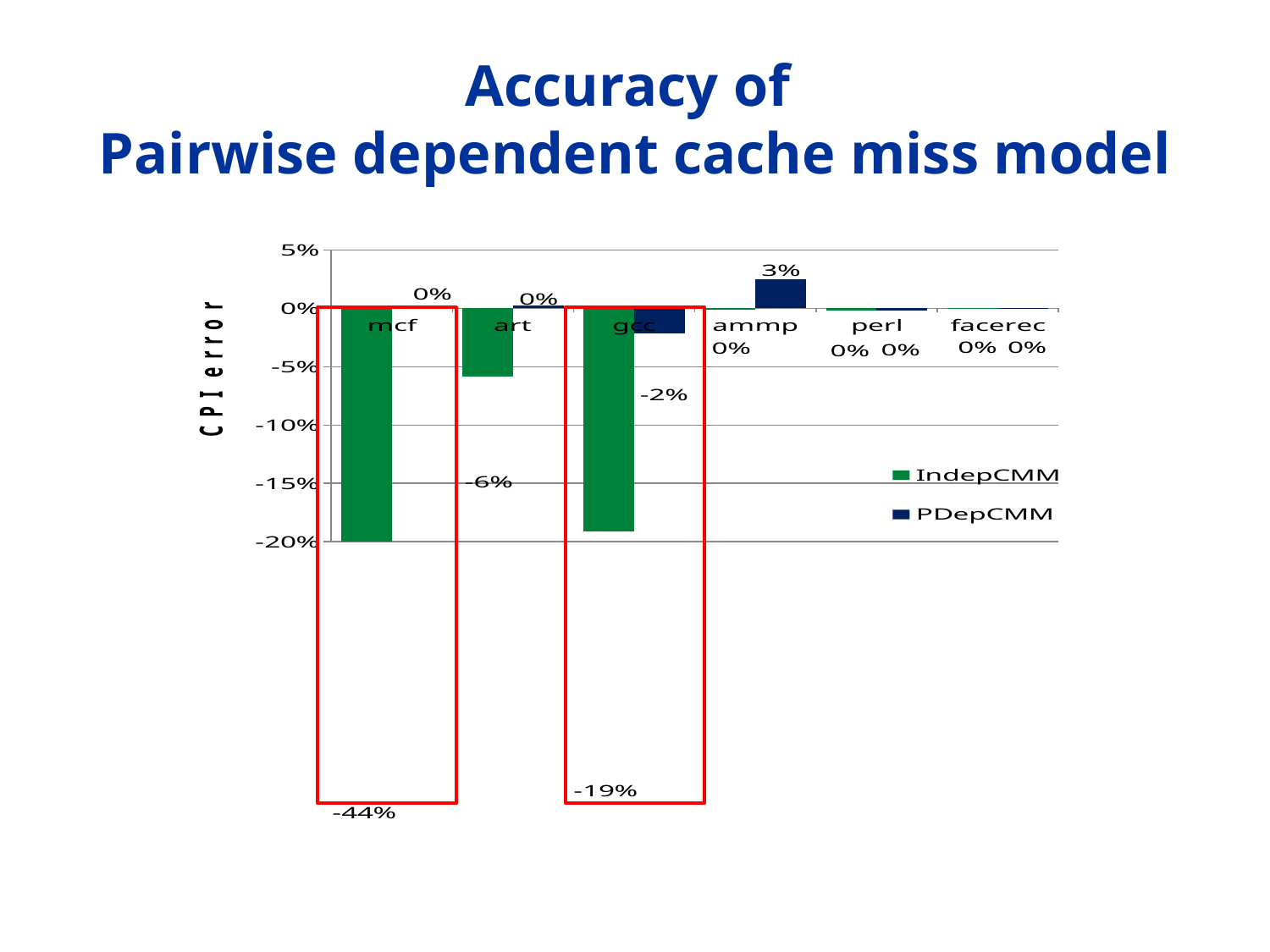
How many categories are shown on the x axis? 6 What is the label of the y axis? CPI error What is the difference between the IndepCMM values for mcf and gcc? 25 percentage points Which category has the highest PDepCMM value? ammp What is the PDepCMM value for ammp? 3% What is the PDepCMM value for gcc? -2% Which has the higher IndepCMM value, art or gcc? art What is the IndepCMM value for mcf? -44% How many series does the legend list? 2 What is the IndepCMM value for gcc? -19% What is the IndepCMM value for art? -6% Which category has the lowest IndepCMM value? mcf